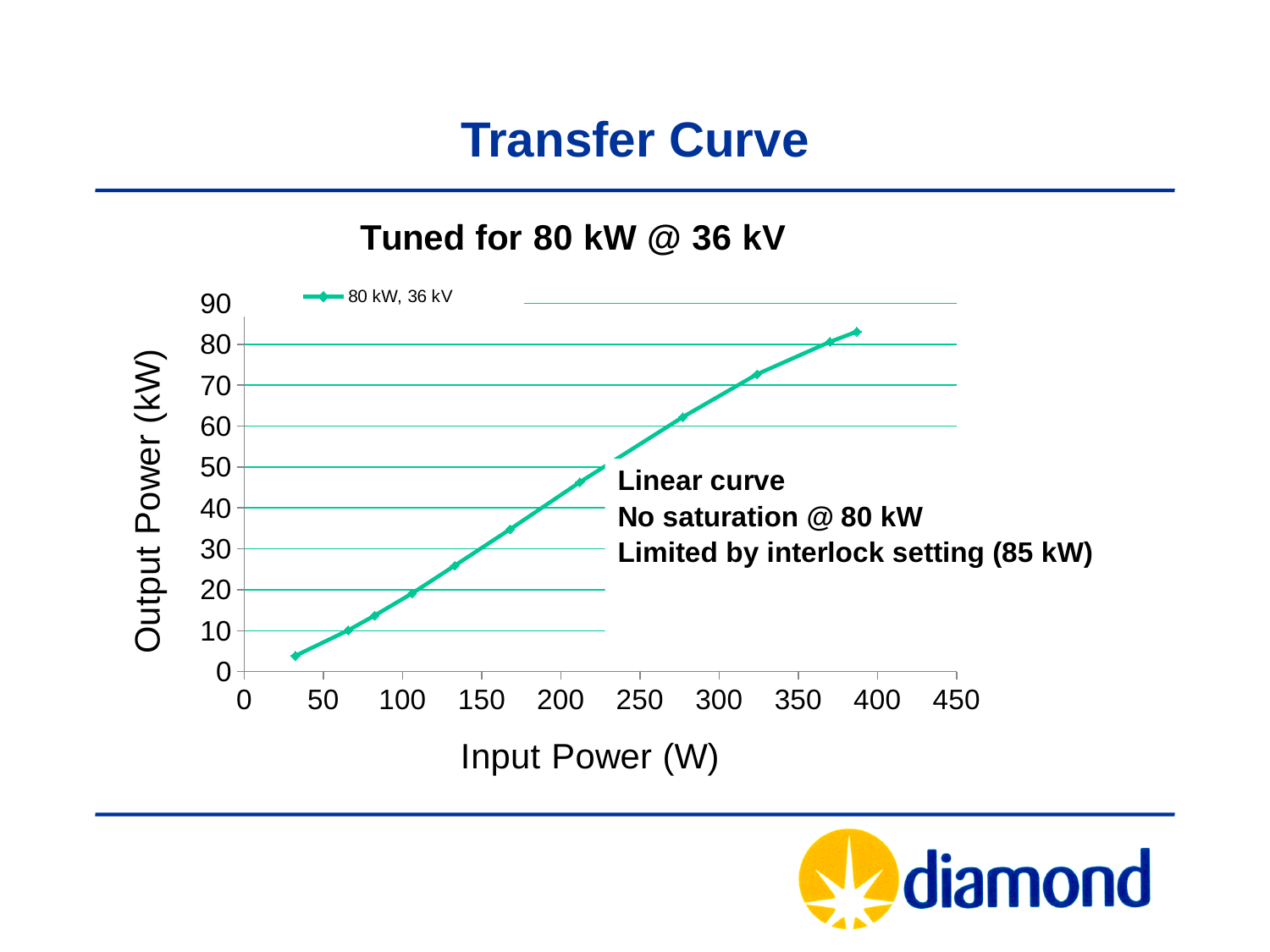
Which is larger: the output power at 350 W input or at 150 W input? 350 W input Is the highest output power value on the curve greater or less than 90 kW? less What is the legend entry for the plotted series? 80 kW, 36 kV Is the output power at an input power of 200 W greater or less than 50 kW? less Is the lowest output power value on the curve greater or less than 10 kW? less What kind of chart is shown on the slide? Line chart Does the output power rise or fall as input power increases along the x axis? Rise What is the title shown above the chart? Tuned for 80 kW @ 36 kV How many series does the legend list? 1